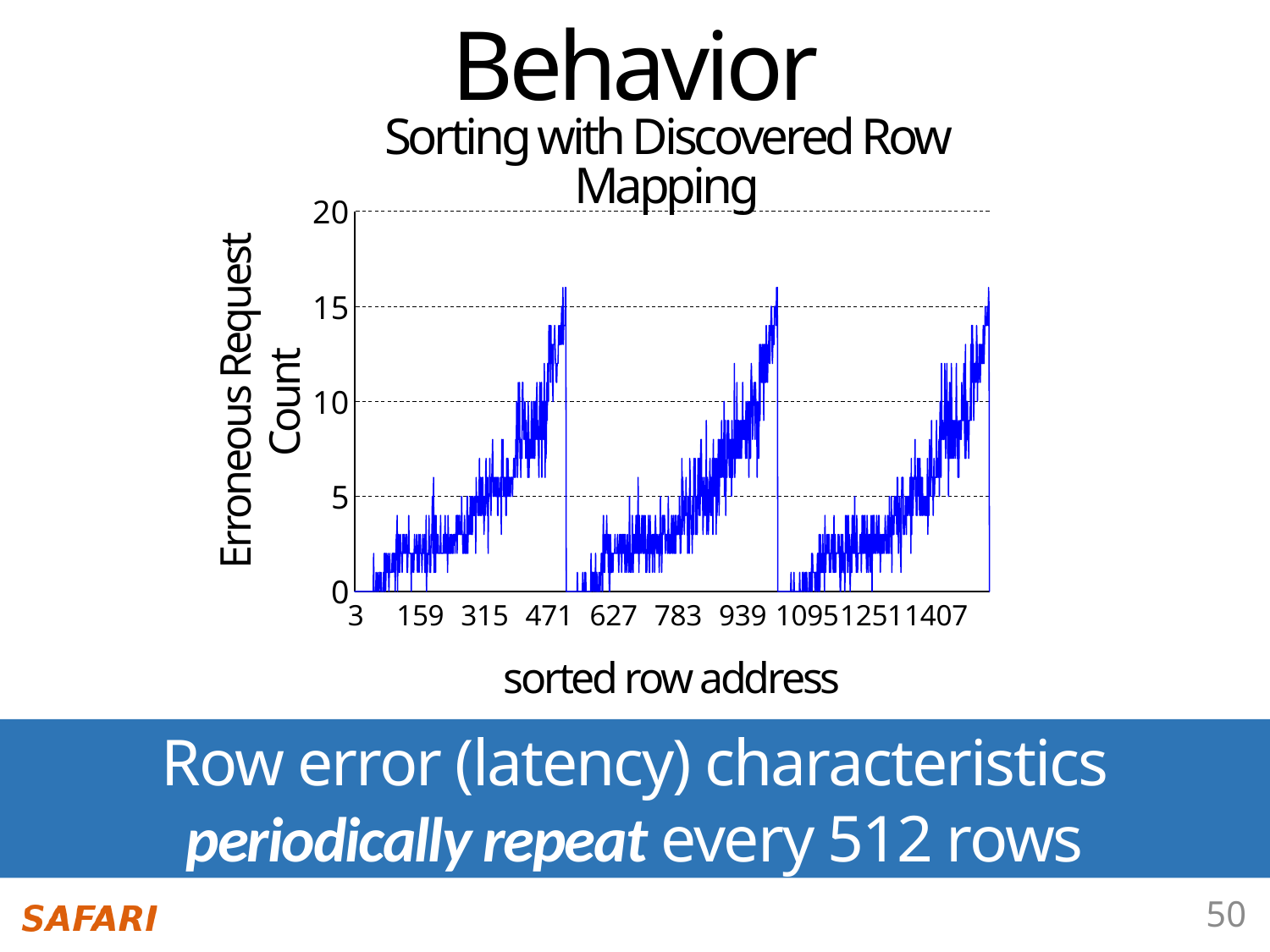
How many tick labels are shown on the x axis of the chart? 10 Is the highest value plotted on the chart greater or less than 10? greater Within each repeating segment, do the values rise or fall as the sorted row address increases? rise What is the title of the chart? Sorting with Discovered Row Mapping Is the value at sorted row address 1095 greater or less than 5? less What kind of chart is shown on the slide? line chart What is the label of the y axis of the chart? Erroneous Request Count Is the value at sorted row address 3 greater or less than 5? less What is the highest tick value shown on the y axis? 20 According to the slide, every how many rows do the row error characteristics repeat? 512 rows